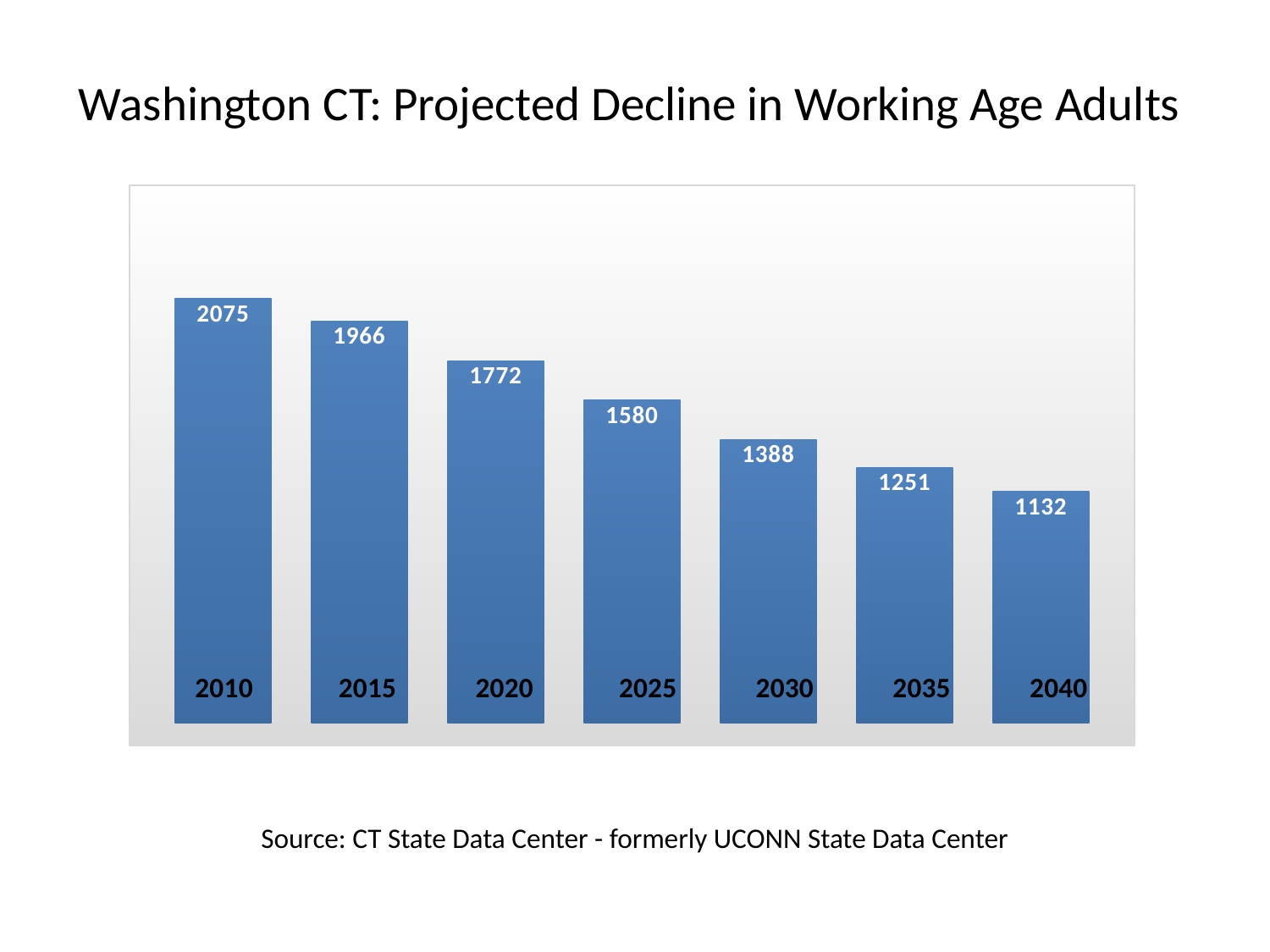
How many years are shown on the chart? 7 What is the projected number of working age adults in 2040? 1132 Which year has the lowest projected number of working age adults? 2040 Do the projected values rise or fall from 2010 to 2040? Fall What is the difference between the projected values for 2020 and 2025? 192 Which year has a larger projected value, 2015 or 2030? 2015 What is the title of the slide? Washington CT: Projected Decline in Working Age Adults Which year has the highest projected number of working age adults? 2010 What kind of chart is shown on the slide? Bar chart What is the projected number of working age adults in 2025? 1580 What is the difference between the projected values for 2010 and 2040? 943 What is the projected number of working age adults in Washington CT in 2010? 2075